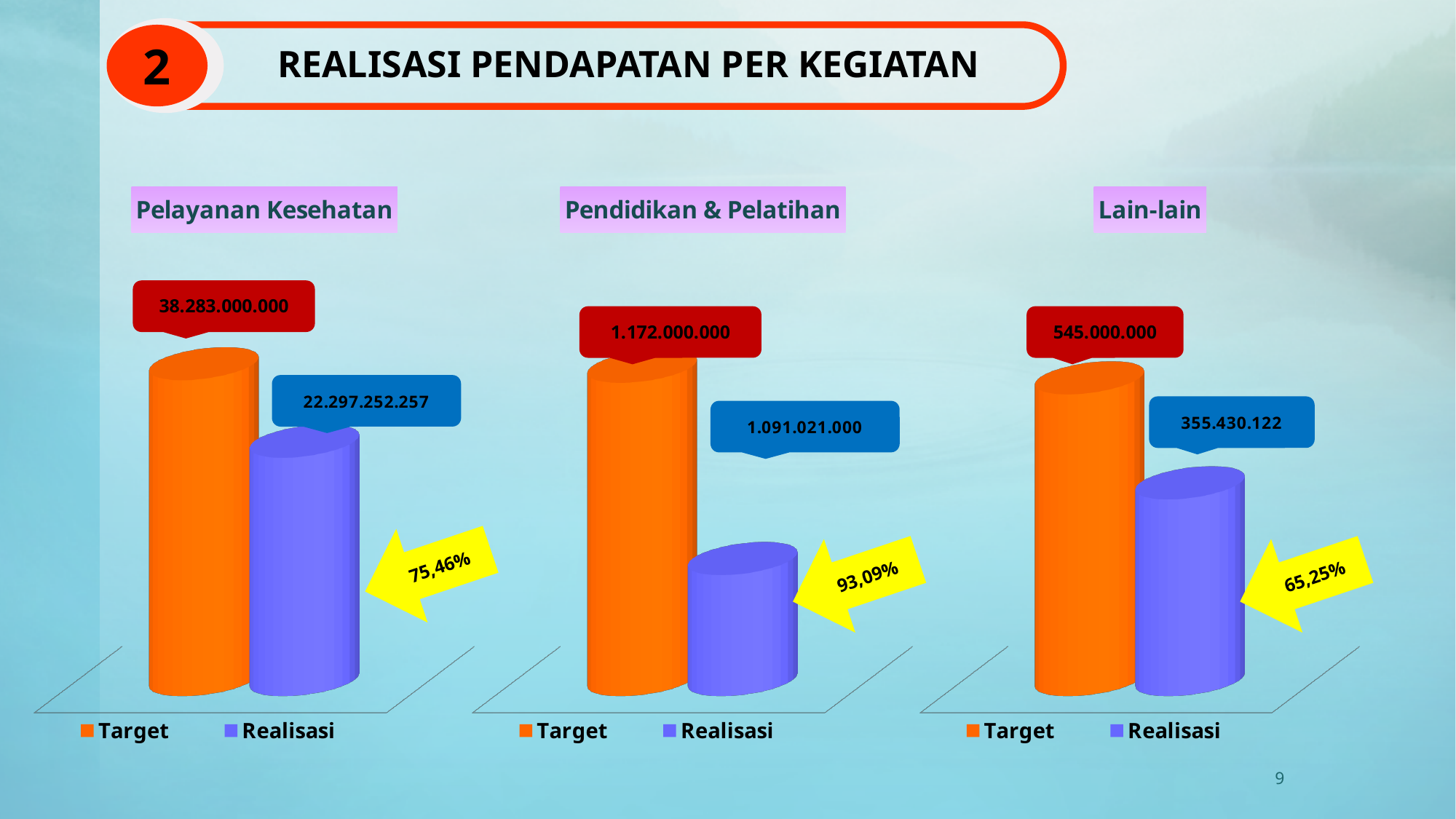
What kind of chart is the Pendidikan & Pelatihan chart? Bar chart In the Lain-lain chart, what is the value of Target? 545.000.000 In the Lain-lain chart, which is larger, Target or Realisasi? Target In the Lain-lain chart, what is the difference between Target and Realisasi? 189.569.878 In the Pelayanan Kesehatan chart, what is the value of Target? 38.283.000.000 In the Pendidikan & Pelatihan chart, what is the difference between Target and Realisasi? 80.979.000 How many series does the legend of the Pelayanan Kesehatan chart list? 2 What percentage is shown in the yellow arrow next to the Pelayanan Kesehatan chart? 75,46% In the Pelayanan Kesehatan chart, what is the value of Realisasi? 22.297.252.257 In the Pendidikan & Pelatihan chart, what is the value of Target? 1.172.000.000 In the Lain-lain chart, what is the value of Realisasi? 355.430.122 In the Pendidikan & Pelatihan chart, what is the value of Realisasi? 1.091.021.000